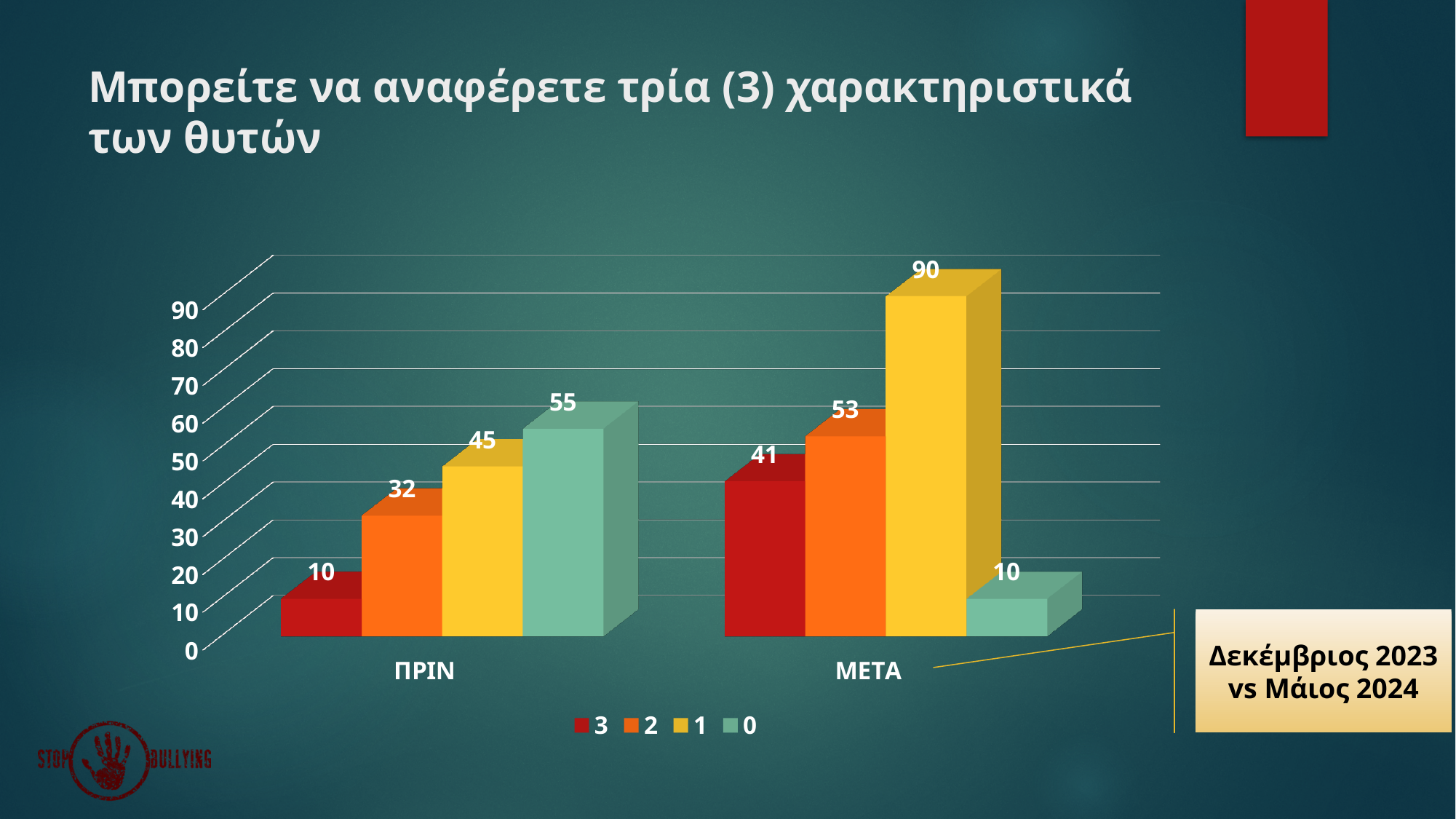
What is the difference between the value for series "0" in ΠΡΙΝ and in ΜΕΤΑ? 45 Which series has the lowest value in the ΜΕΤΑ category? 0 What kind of chart is shown on the slide? bar chart Which is larger: series "2" in ΠΡΙΝ or series "2" in ΜΕΤΑ? ΜΕΤΑ How many series does the legend list? 4 What is the difference between the value for series "1" in ΜΕΤΑ and in ΠΡΙΝ? 45 What colour represents series "3" in the legend? dark red What is the value for series "1" in the ΜΕΤΑ category? 90 What is the value for series "0" in the ΠΡΙΝ category? 55 What is the value for series "3" in the ΜΕΤΑ category? 41 Which series has the highest value in the ΠΡΙΝ category? 0 How many categories are shown on the x axis? 2